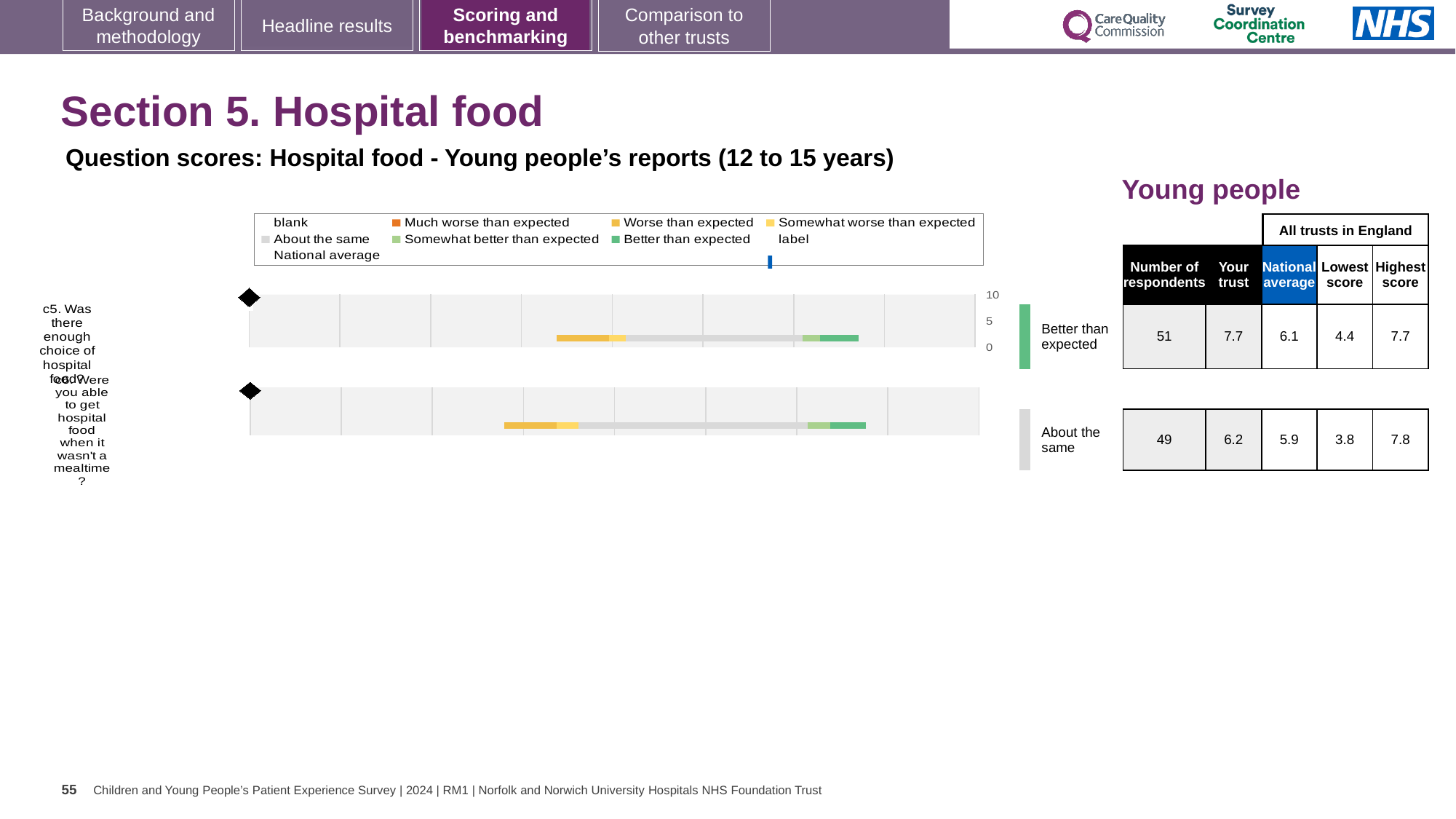
In the table, what is the 'Your trust' score for the row labelled 'Better than expected'? 7.7 In the table, by how much does the 'Your trust' score exceed the national average for the row labelled 'Better than expected'? 1.6 In the table, what is the national average for the row labelled 'Better than expected'? 6.1 What is the maximum value shown on the score axis of the charts? 10 What kind of chart is used to show the question scores for c5 and c6? Bar chart In the table, which row has the larger 'Your trust' score: 'Better than expected' or 'About the same'? Better than expected In the table, what is the number of respondents for the row labelled 'About the same'? 49 In the legend, what colour represents 'Better than expected'? Green How many survey questions are plotted in the charts on this slide? 2 In the table, what is the highest score for the row labelled 'About the same'? 7.8 In the table, what is the lowest score for the row labelled 'About the same'? 3.8 In the table, which row has the larger number of respondents: 'Better than expected' or 'About the same'? Better than expected